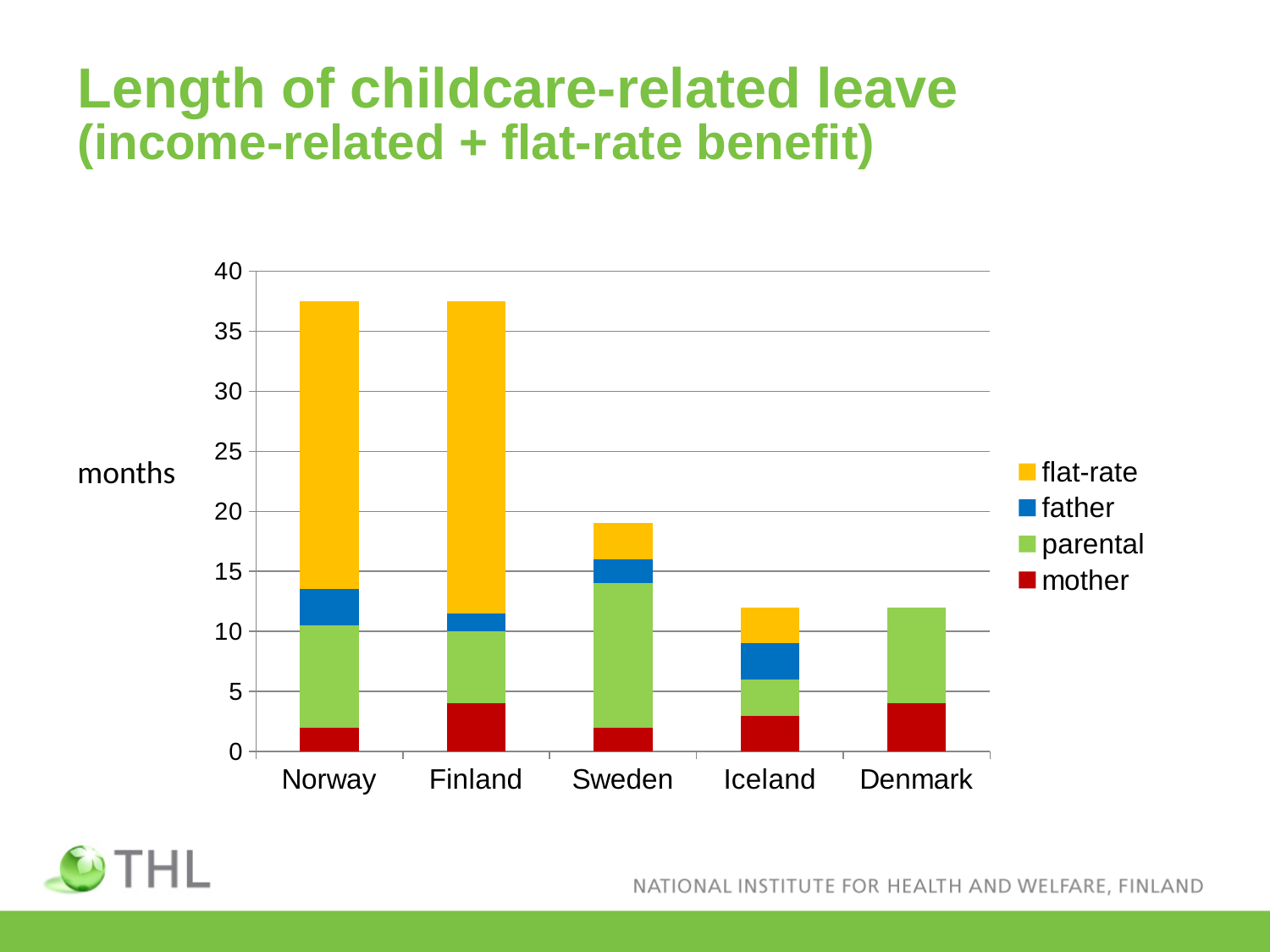
Which has a larger total length of leave, Sweden or Iceland? Sweden Is the total length of leave for Denmark greater or less than 15 months? less How many countries are shown on the x axis of the chart? 5 What kind of chart is shown on the slide? Stacked bar chart How many series does the chart's legend list? 4 Is the total length of leave for Iceland greater or less than 10 months? greater What unit is shown on the y axis label of the chart? months Is the total length of leave for Finland greater or less than 30 months? greater Which country's bar has no flat-rate segment? Denmark Which has a larger total length of leave, Norway or Denmark? Norway